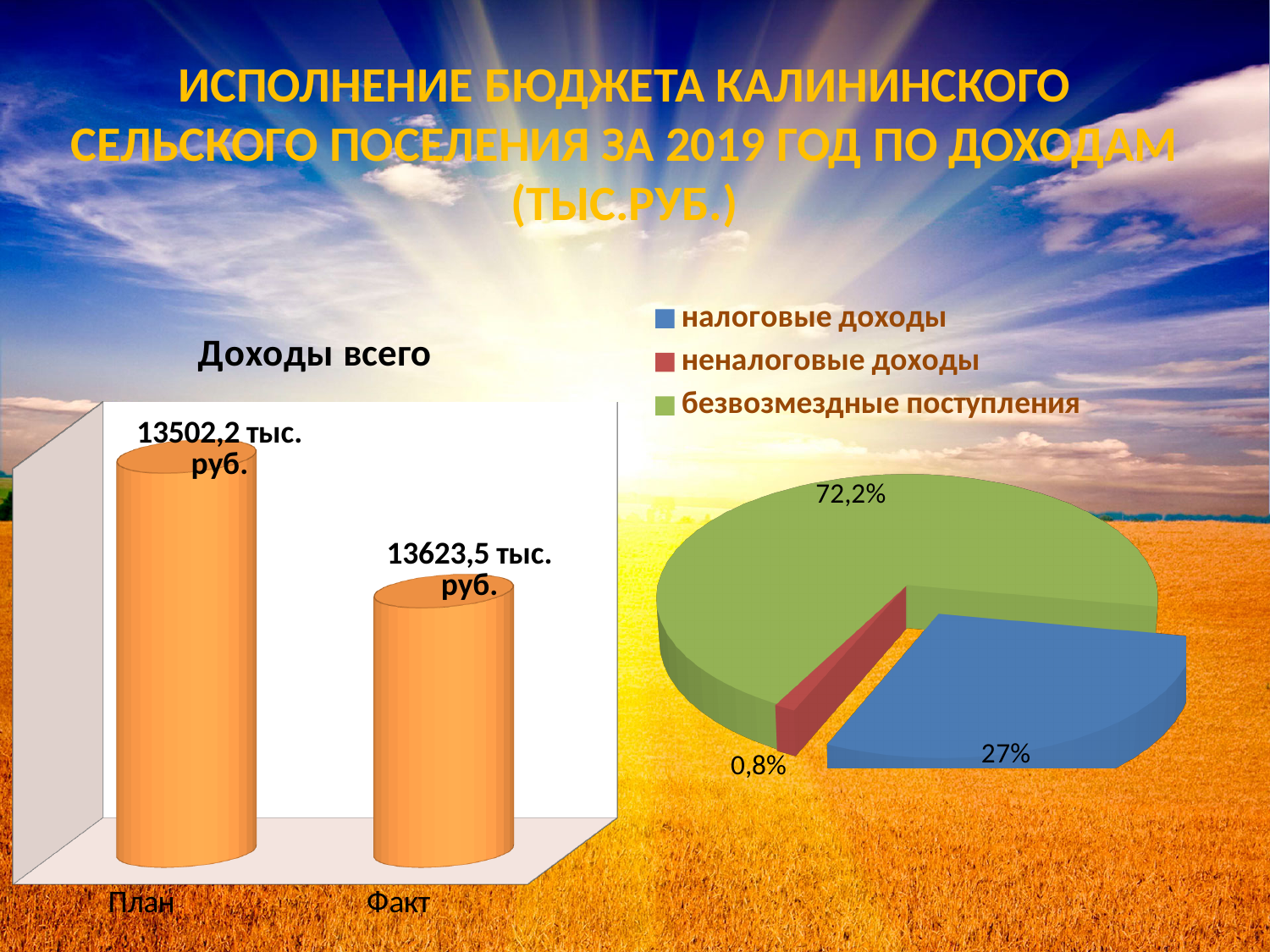
What kind of chart is the chart titled "Доходы всего"? Bar chart In the pie chart on the right, how many categories does the legend list? 3 In the chart titled "Доходы всего", how many categories are shown? 2 In the pie chart on the right, which category has the largest share? безвозмездные поступления In the pie chart on the right, what share is labelled for налоговые доходы? 27% In the chart titled "Доходы всего", what is the value for План? 13502,2 тыс. руб. In the chart titled "Доходы всего", what is the value for Факт? 13623,5 тыс. руб. In the chart titled "Доходы всего", what is the difference between the Факт and План values? 121,3 тыс. руб. In the pie chart on the right, what share is labelled for неналоговые доходы? 0,8% In the pie chart on the right, what share is labelled for безвозмездные поступления? 72,2% In the pie chart on the right, which category has the smallest share? неналоговые доходы In the pie chart on the right, what colour is the slice for налоговые доходы? Blue